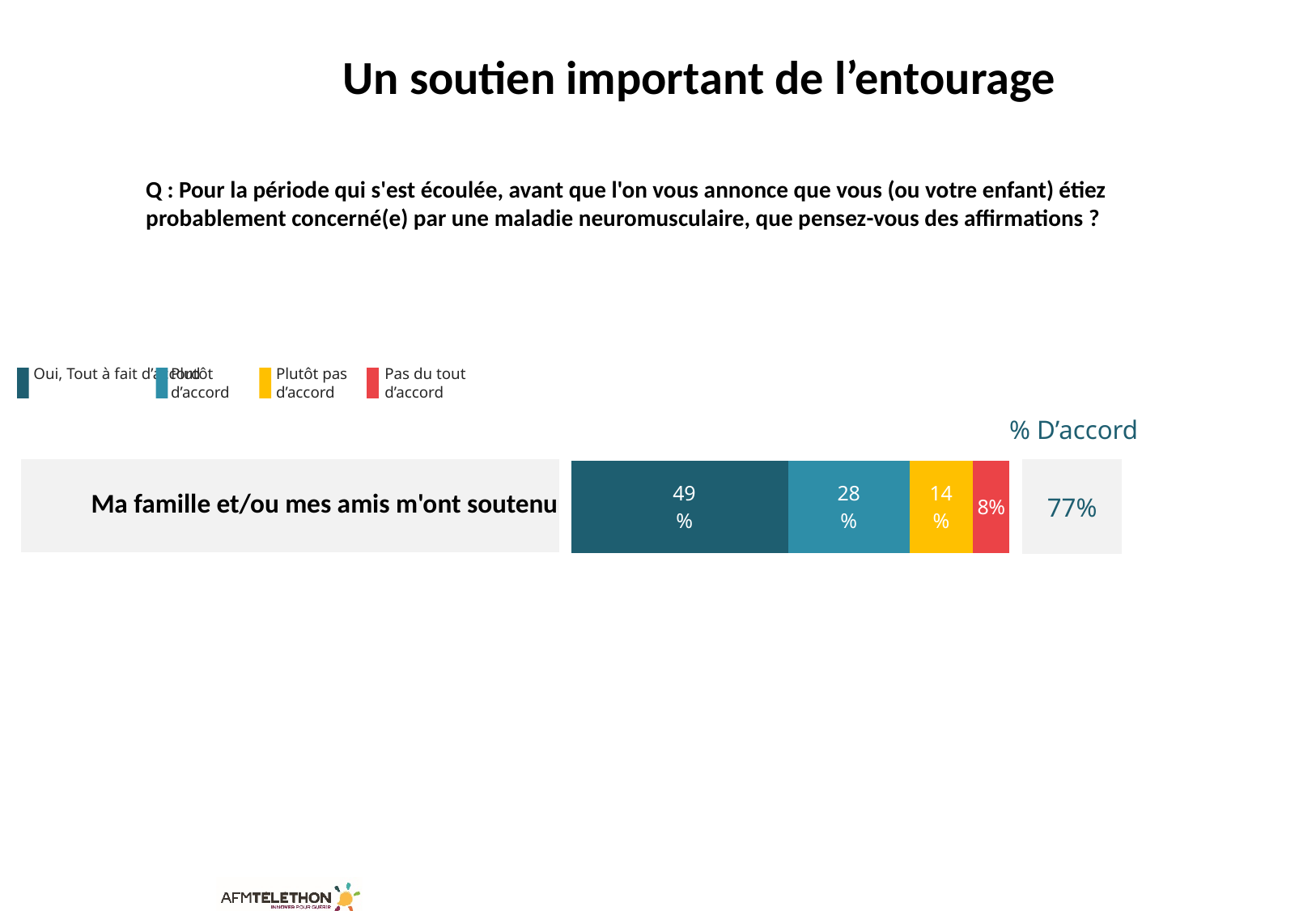
What colour is the segment for "Plutôt pas d'accord"? Yellow Which is larger: the "Plutôt pas d'accord" share or the "Pas du tout d'accord" share? Plutôt pas d'accord What is the difference between the "Oui, Tout à fait d'accord" share and the "Plutôt d'accord" share? 21% What is the "% D'accord" value shown for "Ma famille et/ou mes amis m'ont soutenu"? 77% Which response category has the largest share in the bar? Oui, Tout à fait d'accord What kind of chart is shown on the slide? Stacked bar chart What percentage of respondents answered "Pas du tout d'accord" to "Ma famille et/ou mes amis m'ont soutenu"? 8% What percentage of respondents answered "Plutôt pas d'accord" to "Ma famille et/ou mes amis m'ont soutenu"? 14% Which response category has the smallest share in the bar? Pas du tout d'accord What percentage of respondents answered "Oui, Tout à fait d'accord" to "Ma famille et/ou mes amis m'ont soutenu"? 49% What percentage of respondents answered "Plutôt d'accord" to "Ma famille et/ou mes amis m'ont soutenu"? 28% How many series does the legend list? 4